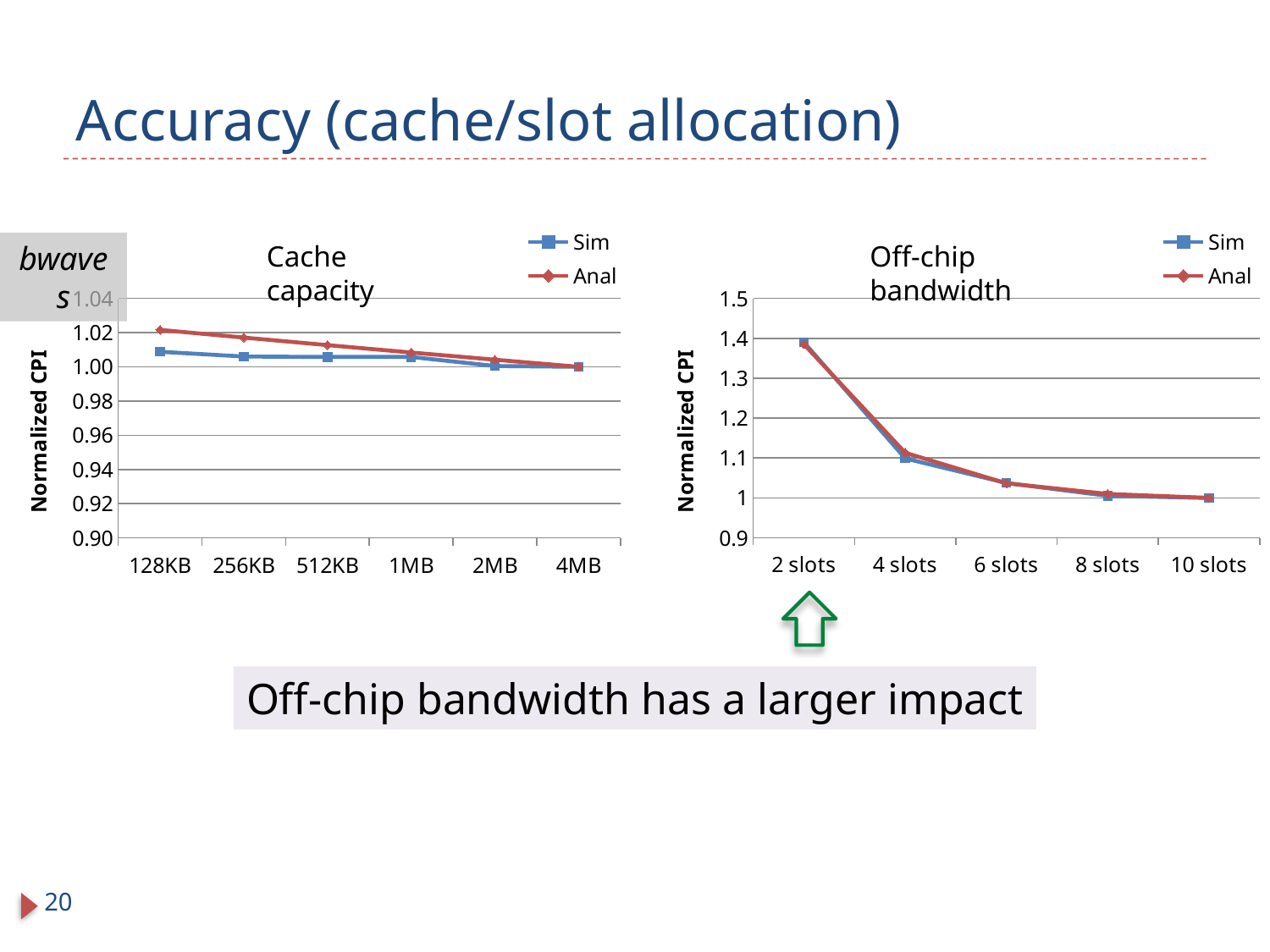
In the Off-chip bandwidth chart, is the Sim value at 2 slots greater or less than 1.3? greater In the Off-chip bandwidth chart, is the Anal value at 4 slots greater or less than 1.2? less How many series does the legend of the Off-chip bandwidth chart list? 2 In the Cache capacity chart, at which category is the Anal series highest? 128KB In the Off-chip bandwidth chart, at which category is the Sim series highest? 2 slots How many categories are on the x axis of the Off-chip bandwidth chart? 5 How many categories are on the x axis of the Cache capacity chart? 6 In the Off-chip bandwidth chart, do the values rise or fall as the number of slots increases? fall What type of chart is the Cache capacity chart? line chart In the Cache capacity chart, which series has the larger value at 128KB, Sim or Anal? Anal In the Cache capacity chart, is the Anal value at 128KB greater or less than 1.00? greater What type of chart is the Off-chip bandwidth chart? line chart